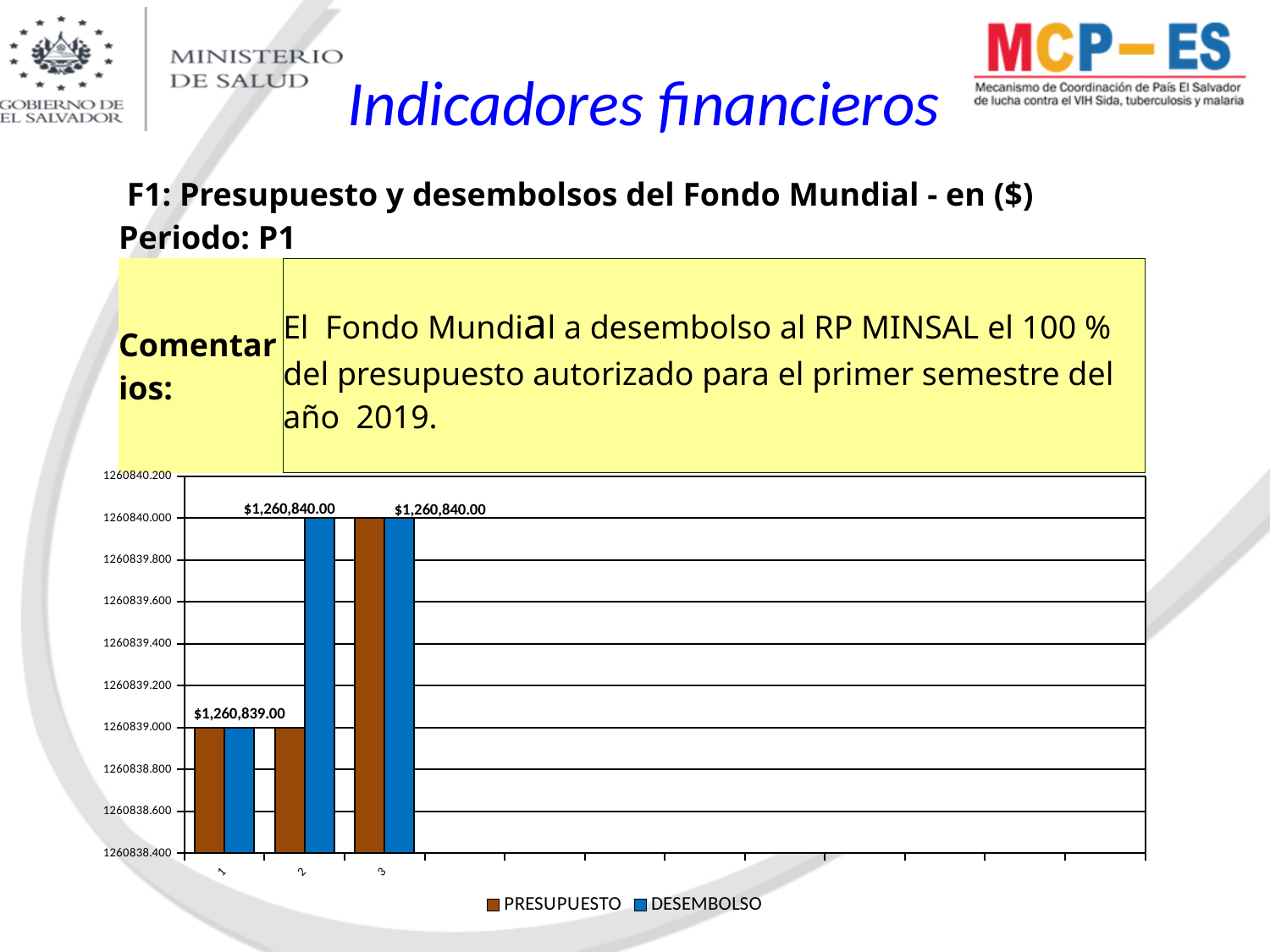
How many categories are plotted on the x axis of the chart? 3 What are the two series named in the chart legend? PRESUPUESTO and DESEMBOLSO What kind of chart is shown on the slide? bar chart What is the DESEMBOLSO value for category 1? $1,260,839.00 For category 2, which is larger, PRESUPUESTO or DESEMBOLSO? DESEMBOLSO What is the DESEMBOLSO value for category 3? $1,260,840.00 What is the difference between the DESEMBOLSO value for category 3 and for category 1? $1.00 How many series does the chart legend list? 2 What colour are the PRESUPUESTO bars in the chart? brown Is the PRESUPUESTO value for category 2 greater or less than 1260839.600? less What is the DESEMBOLSO value for category 2? $1,260,840.00 Which category has the highest PRESUPUESTO value? 3